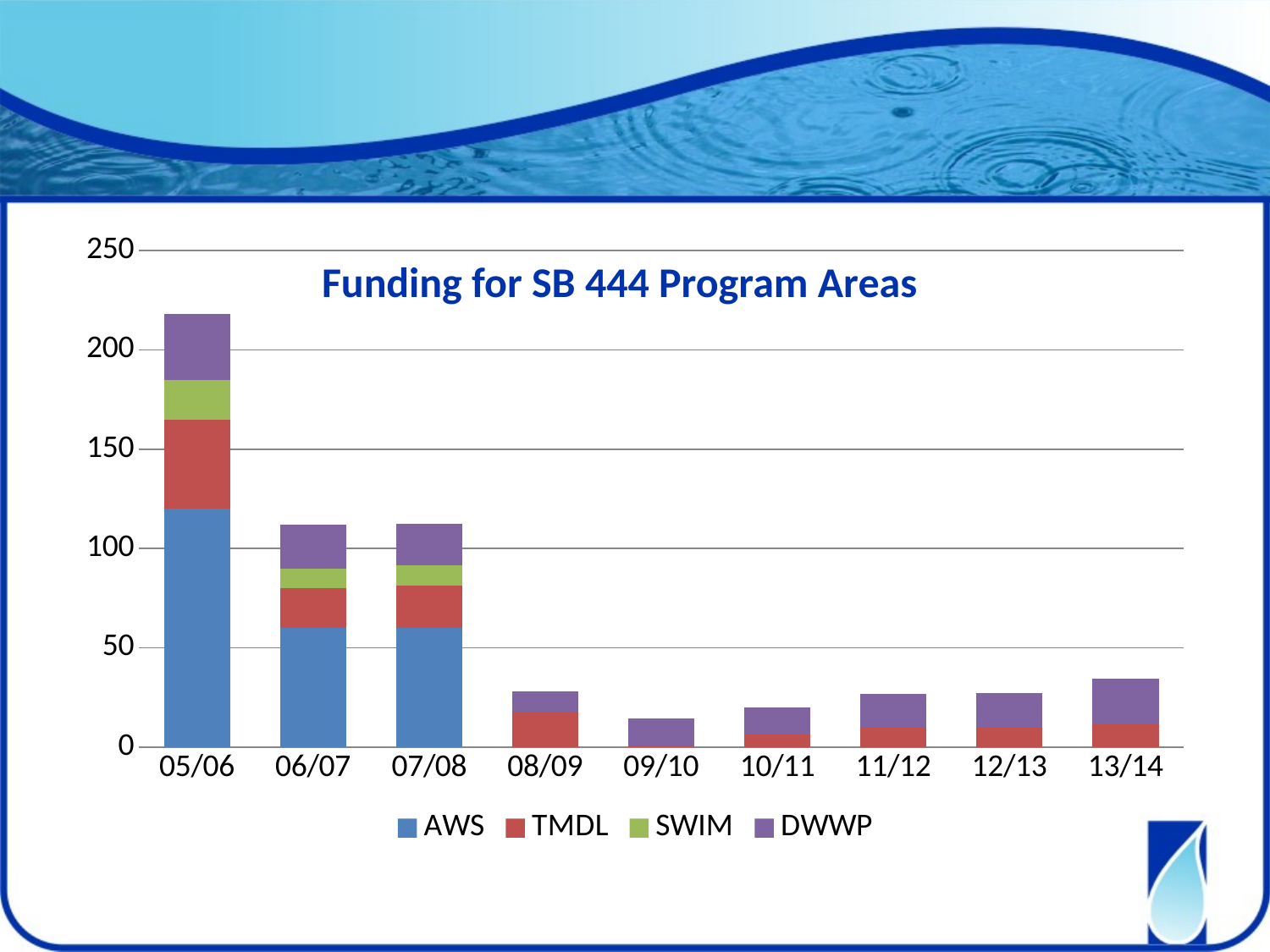
What is the title of the chart? Funding for SB 444 Program Areas How many series does the legend list? 4 How many fiscal-year categories are shown on the x axis? 9 Which fiscal year has the highest total funding? 05/06 Does total funding rise or fall from 05/06 to 09/10? fall Which fiscal year has the lowest total funding? 09/10 What type of chart is shown on the slide? Stacked bar chart Is the AWS value for 05/06 greater or less than 100? greater Is the total funding for 13/14 greater or less than 50? less Is the total funding for 05/06 greater or less than 200? greater Which series is shown in purple in the legend? DWWP Which has the larger total funding, 05/06 or 06/07? 05/06